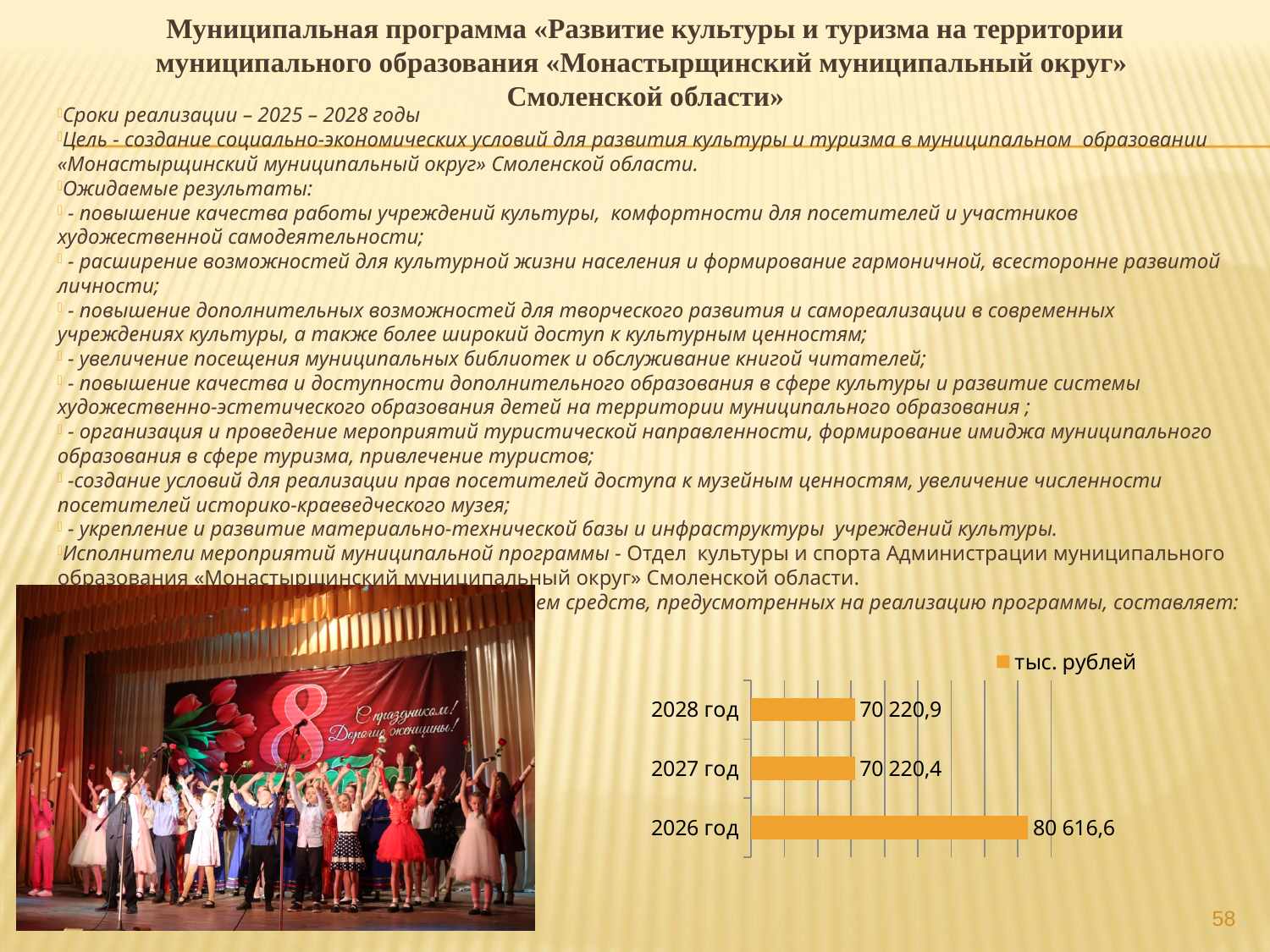
How many years are shown in the chart? 3 What is the difference between the values for 2026 год and 2028 год? 10 395,7 Which year has the highest value in the chart? 2026 год What kind of chart is shown on the slide? bar chart Which year has the lowest value in the chart? 2027 год What is the difference between the values for 2026 год and 2027 год? 10 396,2 What is the value for 2026 год in the chart? 80 616,6 What is the difference between the values for 2028 год and 2027 год? 0,5 How many series does the chart legend list? 1 Which is larger, the value for 2026 год or the value for 2028 год? 2026 год What is the value for 2027 год in the chart? 70 220,4 What is the value for 2028 год in the chart? 70 220,9